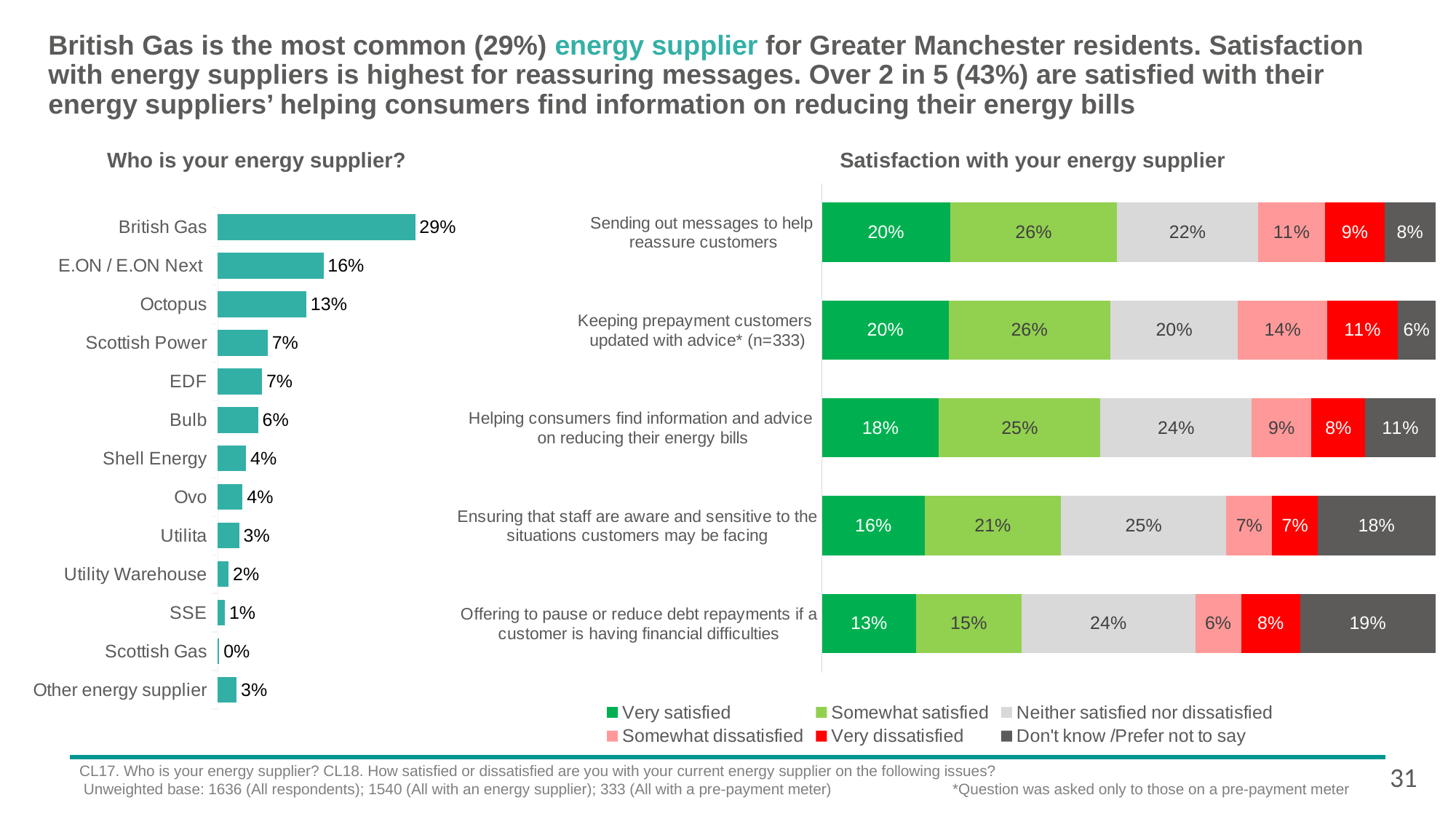
How many series does the legend of the 'Satisfaction with your energy supplier' chart list? 6 In the 'Satisfaction with your energy supplier' chart, what is the combined total of 'Very satisfied' and 'Somewhat satisfied' for 'Helping consumers find information and advice on reducing their energy bills'? 43% In the 'Who is your energy supplier?' chart, which is larger, Bulb or Utilita? Bulb In the 'Satisfaction with your energy supplier' chart, which item has the highest 'Very dissatisfied' value? Keeping prepayment customers updated with advice* (n=333) In the 'Satisfaction with your energy supplier' chart, what percentage are very satisfied with 'Sending out messages to help reassure customers'? 20% In the 'Who is your energy supplier?' chart, which supplier has the lowest value? Scottish Gas In the 'Who is your energy supplier?' chart, what percentage of residents use British Gas? 29% In the 'Who is your energy supplier?' chart, what is the difference between British Gas and E.ON / E.ON Next? 13% In the 'Who is your energy supplier?' chart, what is the value for Octopus? 13% What kind of chart is 'Who is your energy supplier?' Bar chart In the 'Satisfaction with your energy supplier' chart, what is the 'Don't know /Prefer not to say' value for 'Offering to pause or reduce debt repayments if a customer is having financial difficulties'? 19% How many suppliers are listed in the 'Who is your energy supplier?' chart? 13